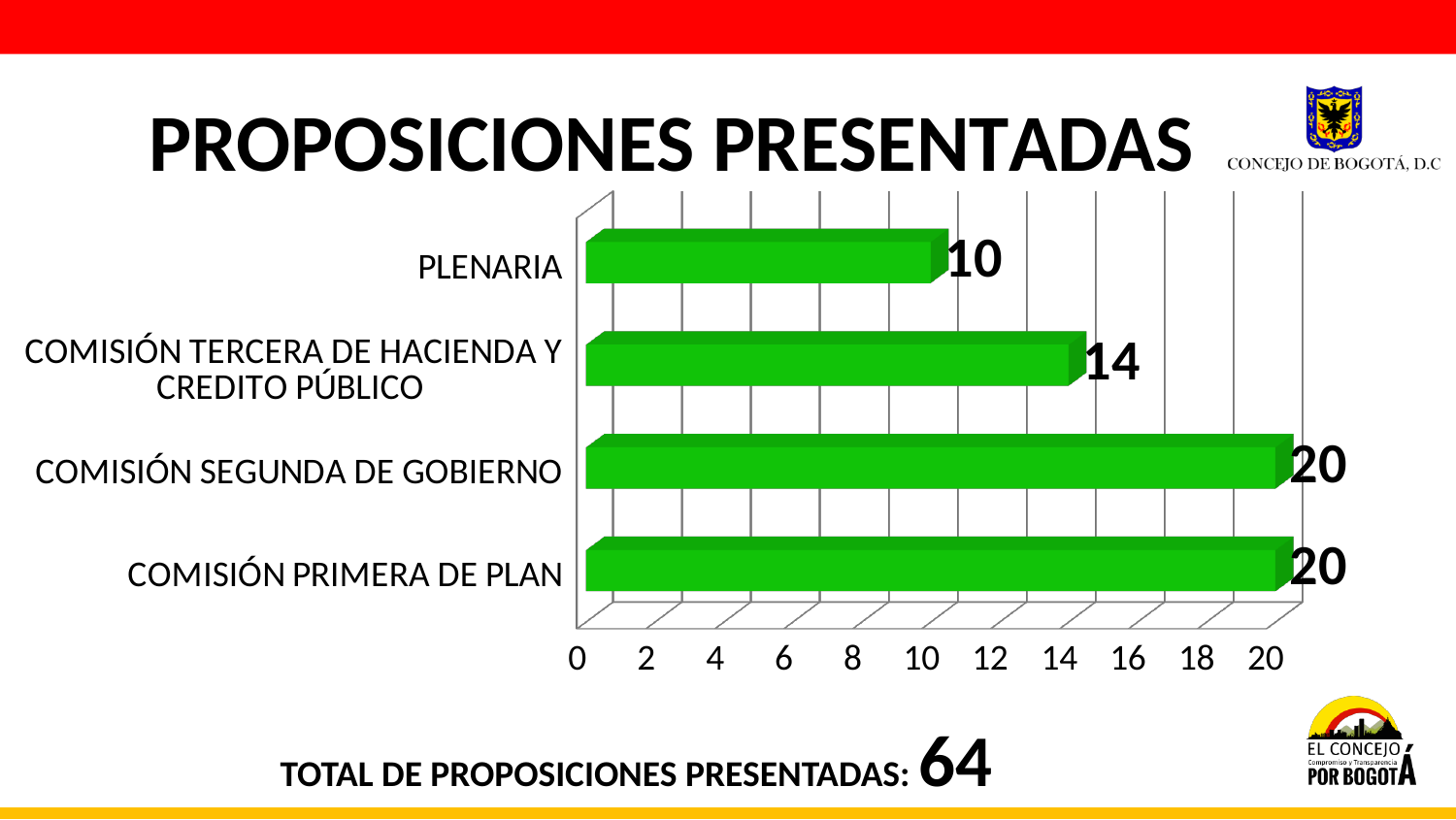
Which category has the lowest value? PLENARIA What is the title of the chart? PROPOSICIONES PRESENTADAS What is the difference between the values for COMISIÓN TERCERA DE HACIENDA Y CREDITO PÚBLICO and PLENARIA? 4 What is the value for PLENARIA? 10 Is the value for COMISIÓN TERCERA DE HACIENDA Y CREDITO PÚBLICO greater or less than 12? greater What is the value for COMISIÓN TERCERA DE HACIENDA Y CREDITO PÚBLICO? 14 What kind of chart is shown on the slide? bar chart What is the difference between the values for COMISIÓN SEGUNDA DE GOBIERNO and PLENARIA? 10 What is the value for COMISIÓN SEGUNDA DE GOBIERNO? 20 Which is larger, the value for COMISIÓN TERCERA DE HACIENDA Y CREDITO PÚBLICO or the value for PLENARIA? COMISIÓN TERCERA DE HACIENDA Y CREDITO PÚBLICO How many categories are shown in the chart? 4 What is the value for COMISIÓN PRIMERA DE PLAN? 20